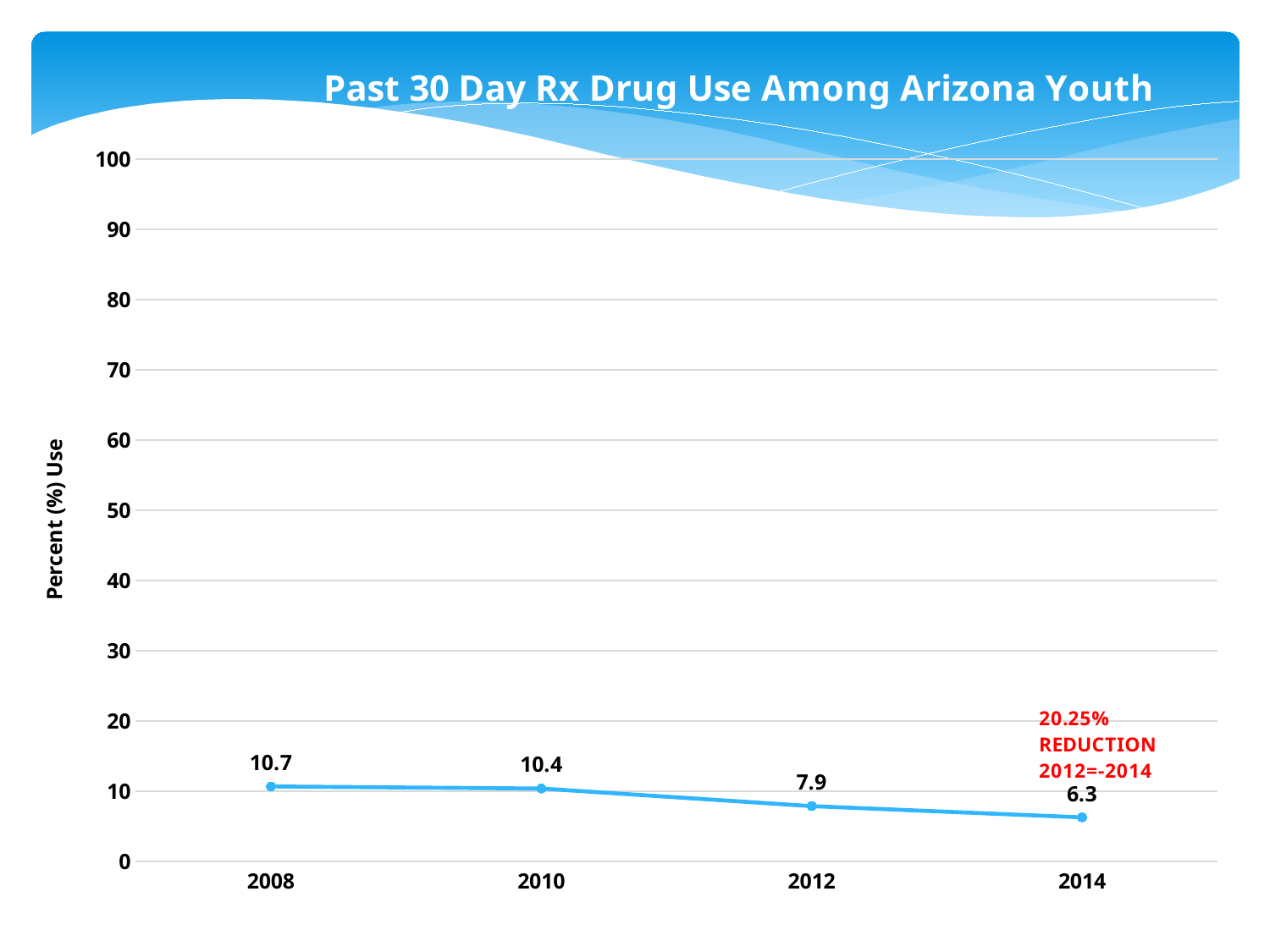
What is the value for 2008? 10.7 What is the value for 2014? 6.3 Which is larger, the value for 2010 or the value for 2012? 2010 What is the difference between the values for 2008 and 2014? 4.4 How many data points are plotted on the chart? 4 Do the values rise or fall from 2008 to 2014? fall What is the value for 2012? 7.9 What kind of chart is shown on the slide? line chart Which year has the lowest value? 2014 Which year has the highest value? 2008 What is the difference between the values for 2010 and 2012? 2.5 Is the value for 2014 greater or less than 10? less